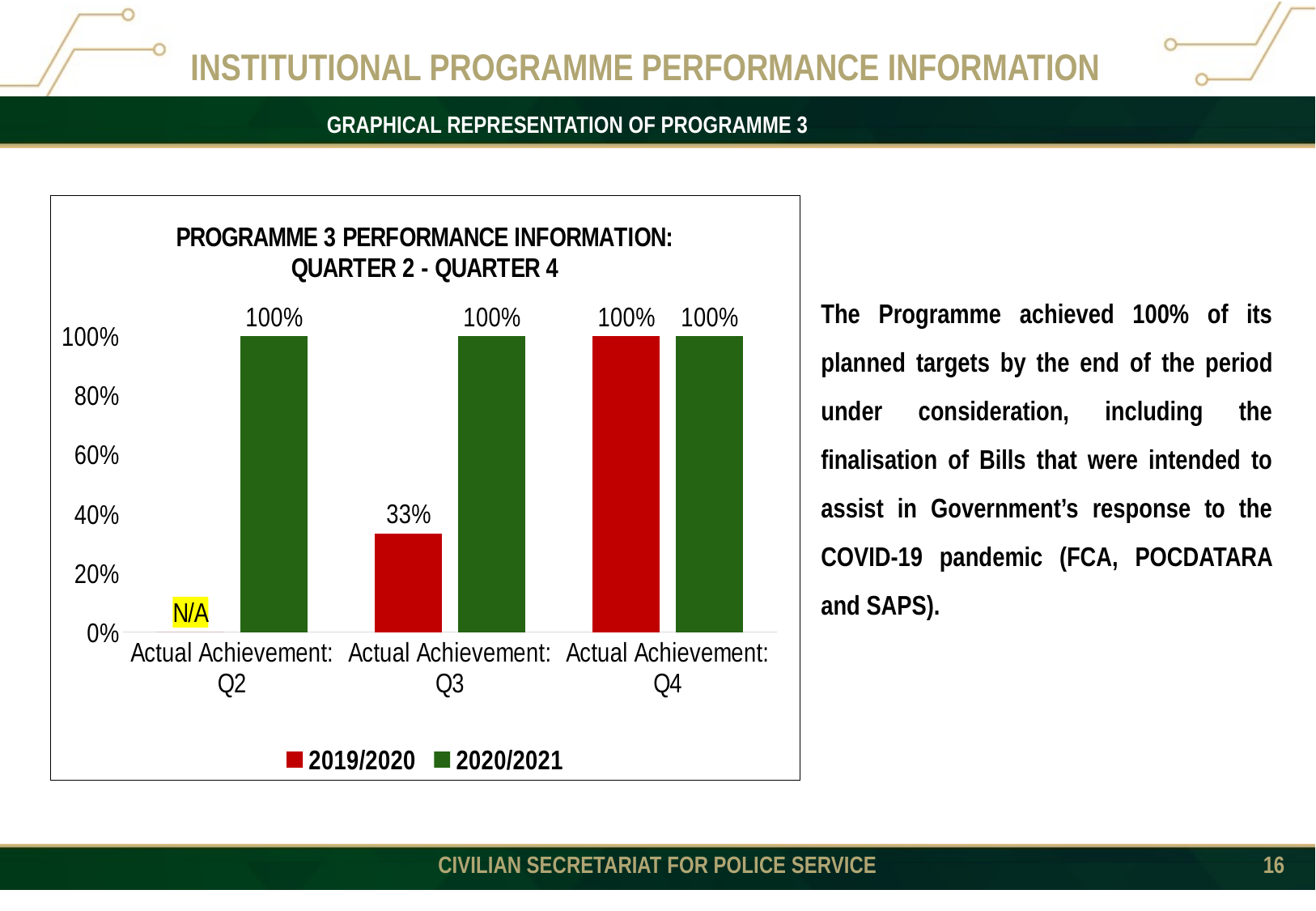
Is the 2019/2020 value for Actual Achievement: Q3 greater or less than 40%? less What is the 2019/2020 value for Actual Achievement: Q4? 100% What is the title of the chart? PROGRAMME 3 PERFORMANCE INFORMATION: QUARTER 2 - QUARTER 4 How many series does the legend list? 2 For Actual Achievement: Q3, which series has the larger value, 2019/2020 or 2020/2021? 2020/2021 What label is shown for the 2019/2020 series at Actual Achievement: Q2? N/A Which quarter has the lowest 2019/2020 value among those with a plotted bar? Actual Achievement: Q3 What is the 2019/2020 value for Actual Achievement: Q3? 33% What is the 2020/2021 value for Actual Achievement: Q2? 100% What kind of chart is shown on the slide? bar chart What is the difference between the 2020/2021 and 2019/2020 values for Actual Achievement: Q3? 67% How many categories are shown on the x axis? 3